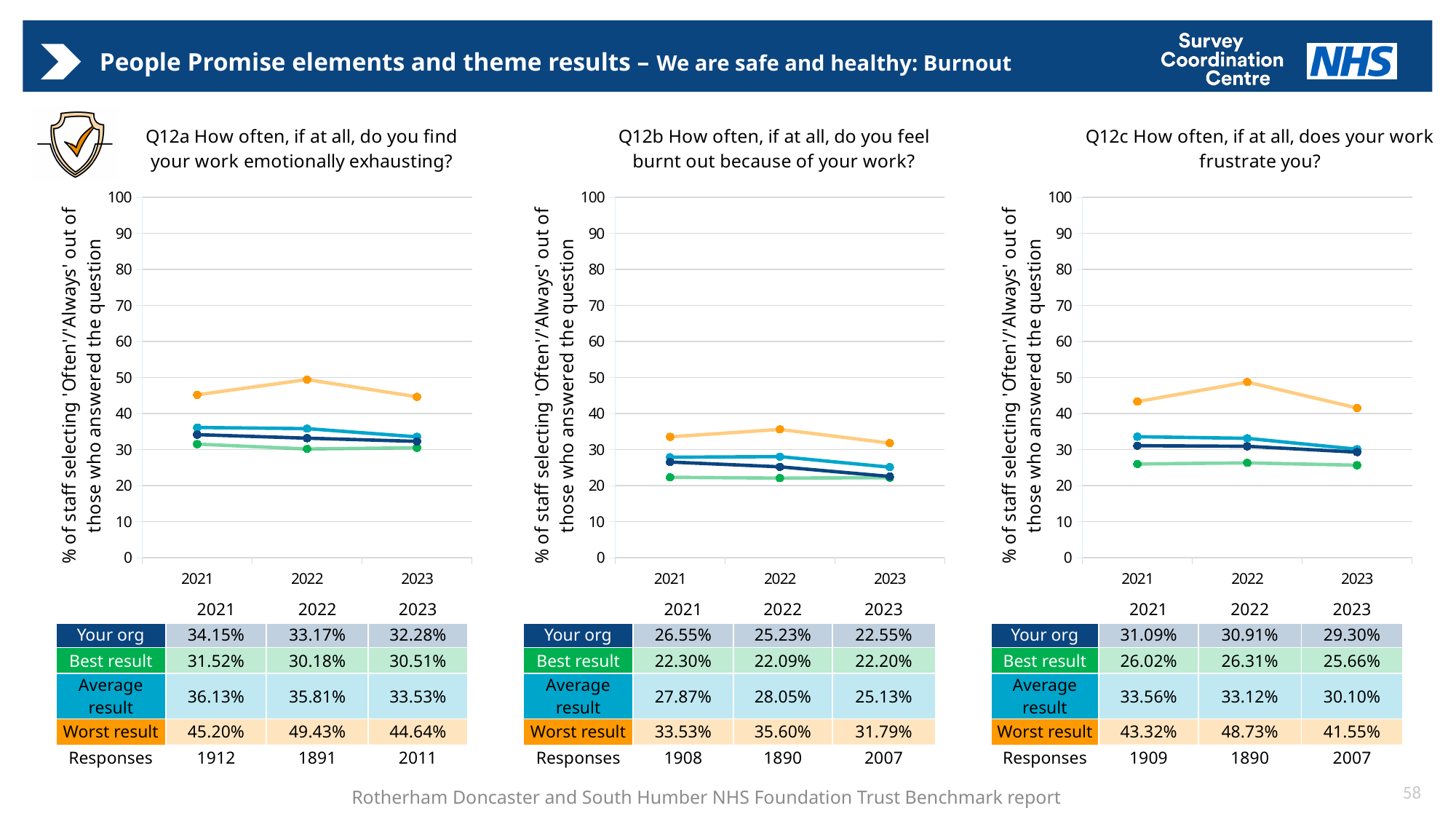
On the Q12b chart (How often do you feel burnt out because of your work?), what is the 'Worst result' value for 2022? 35.60% On the Q12c chart, does the 'Your org' line rise or fall from 2021 to 2023? Fall How many responses are recorded for 2023 on the Q12a chart? 2011 How many years are plotted on the x axis of the Q12c chart? 3 What kind of chart is used for Q12a? Line chart On the Q12c chart, what is the difference between the 'Worst result' and 'Best result' values for 2022? 22.42% On the Q12b chart, which year has the lowest 'Your org' value? 2023 On the Q12a chart, which is larger in 2021: the 'Your org' value or the 'Average result' value? Average result On the Q12b chart, is the 'Worst result' value for 2021 greater or less than 30? greater On the Q12a chart (How often do you find your work emotionally exhausting?), what is the 'Your org' value for 2023? 32.28% On the Q12c chart (How often does your work frustrate you?), what is the 'Average result' value for 2021? 33.56% On the Q12a chart, which year has the highest 'Worst result' value? 2022